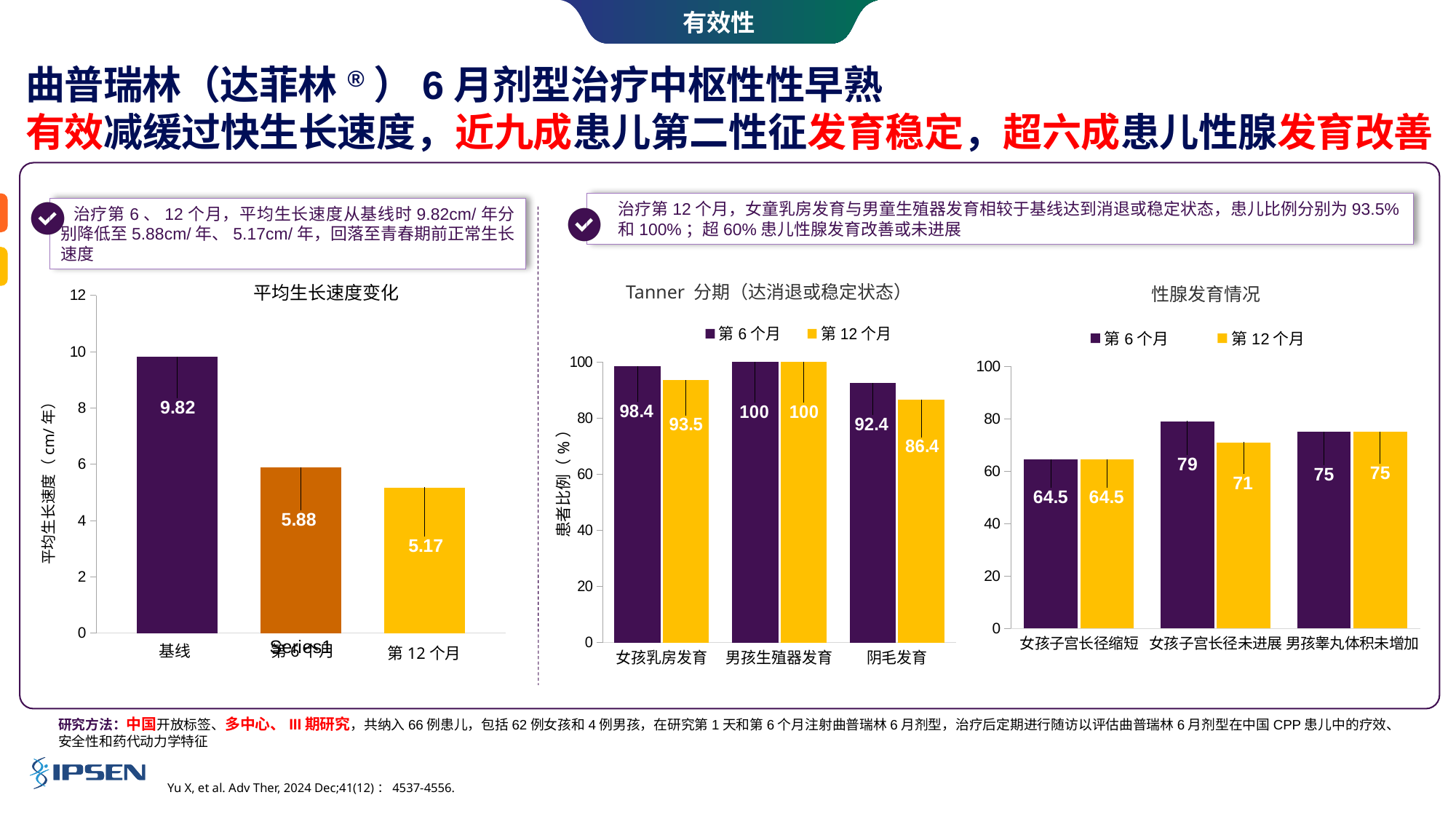
In the Tanner 分期（达消退或稳定状态） chart, how many series does the legend list? 2 In the 性腺发育情况 chart, which category has the lowest 第 6 个月 value? 女孩子宫长径缩短 In the 平均生长速度变化 chart, which category has the highest value? 基线 In the 平均生长速度变化 chart, what is the value for 第 12 个月? 5.17 In the Tanner 分期（达消退或稳定状态） chart, what is the difference between the 第 6 个月 and 第 12 个月 values for 阴毛发育? 6 In the 平均生长速度变化 chart, do the values rise or fall from 基线 to 第 12 个月? fall In the 平均生长速度变化 chart, what is the difference between the 基线 value and the 第 12 个月 value? 4.65 In the 性腺发育情况 chart, what is the 第 12 个月 value for 女孩子宫长径未进展? 71 In the 平均生长速度变化 chart, what is the value for 基线? 9.82 What kind of chart is the 性腺发育情况 chart? bar chart In the Tanner 分期（达消退或稳定状态） chart, what is the 第 12 个月 value for 女孩乳房发育? 93.5 In the Tanner 分期（达消退或稳定状态） chart, what is the 第 6 个月 value for 阴毛发育? 92.4